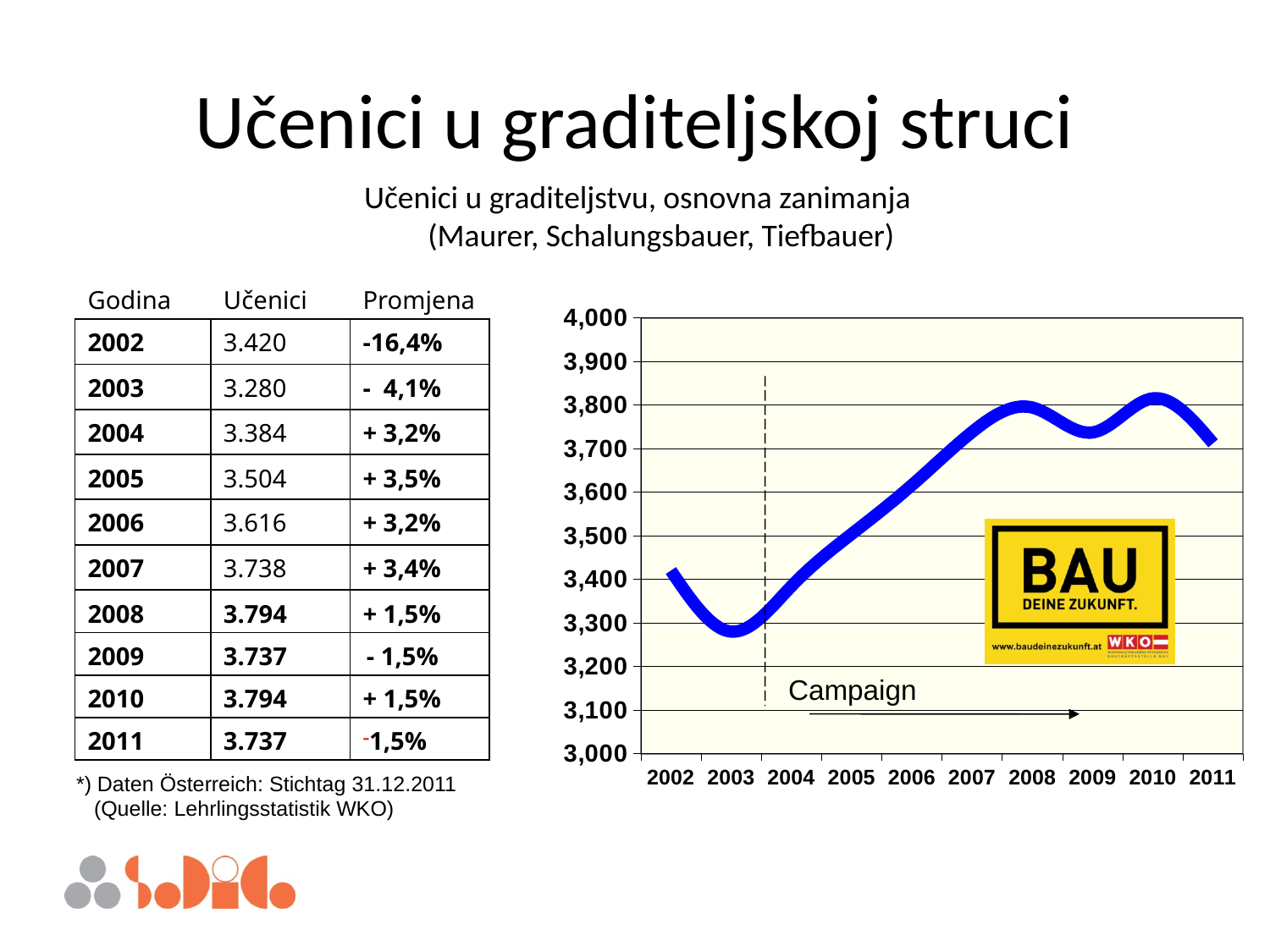
Does the line rise or fall between 2003 and 2008? rise How many years are plotted along the x axis of the chart? 10 In which year does the line reach its lowest point? 2003 Is the value plotted for 2002 greater or less than 3,500? less Is the value plotted for 2007 greater or less than 3,600? greater What is the difference between the number of Učenici in 2008 and in 2002? 374 According to the slide, how many Učenici were there in 2003? 3.280 According to the slide, how many Učenici were there in 2006? 3.616 Is the value plotted for 2011 greater or less than 3,600? greater What label is written next to the dashed vertical line and arrow on the chart? Campaign What kind of chart is shown on the right of the slide? line chart Which year has the larger value, 2005 or 2009? 2009